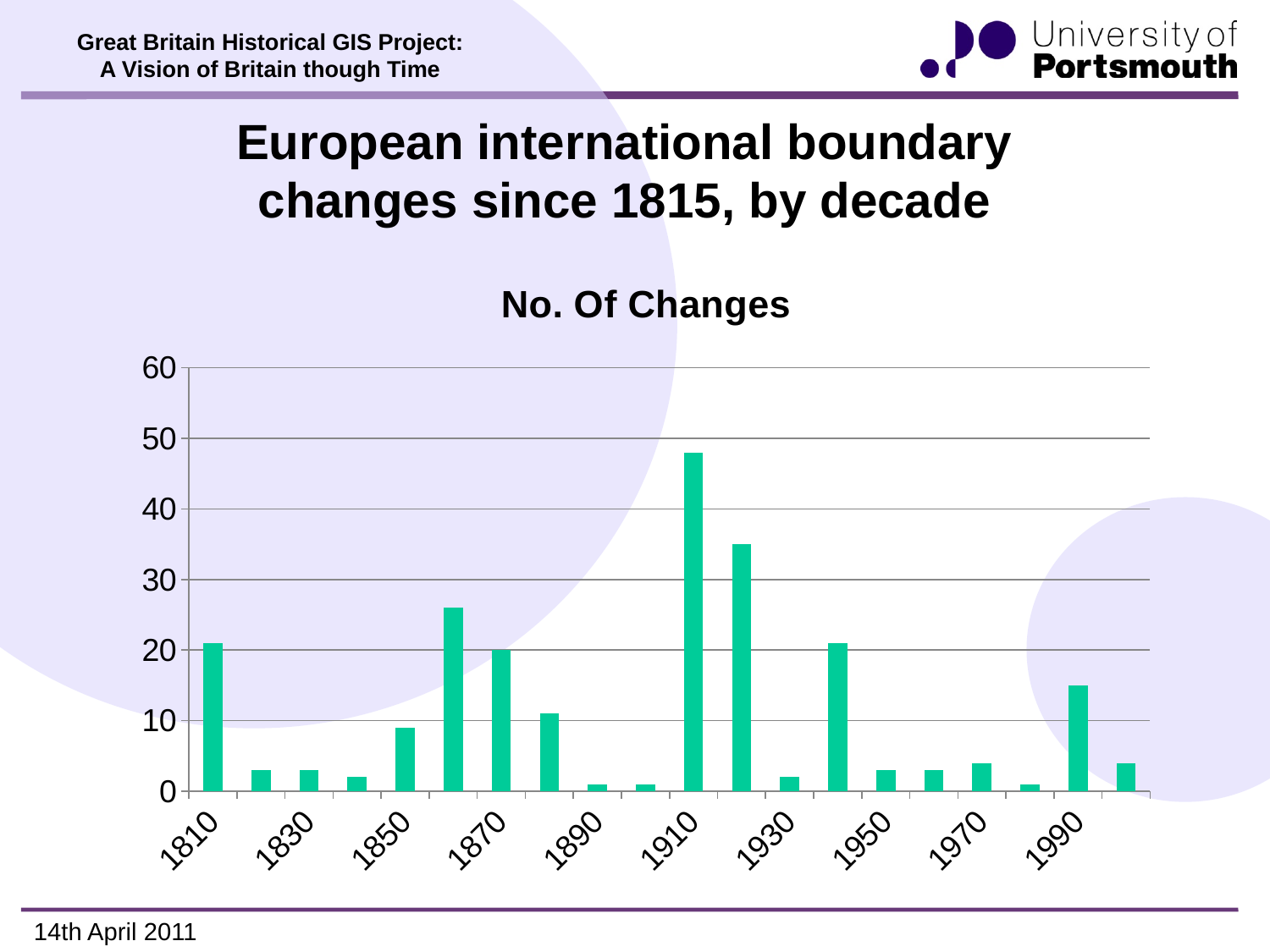
Which is larger, the value for 1990 or the value for 1970? 1990 Is the value for 1950 greater or less than 10? less How many bars are plotted in the chart? 20 Is the value for 1830 greater or less than 10? less What is the title shown directly above the chart? No. Of Changes Which is larger, the value for 1910 or the value for 1930? 1910 Which decade has the highest number of changes? 1910 Is the value for 1930 greater or less than 10? less Which is larger, the value for 1810 or the value for 1830? 1810 What kind of chart is shown on the slide? bar chart